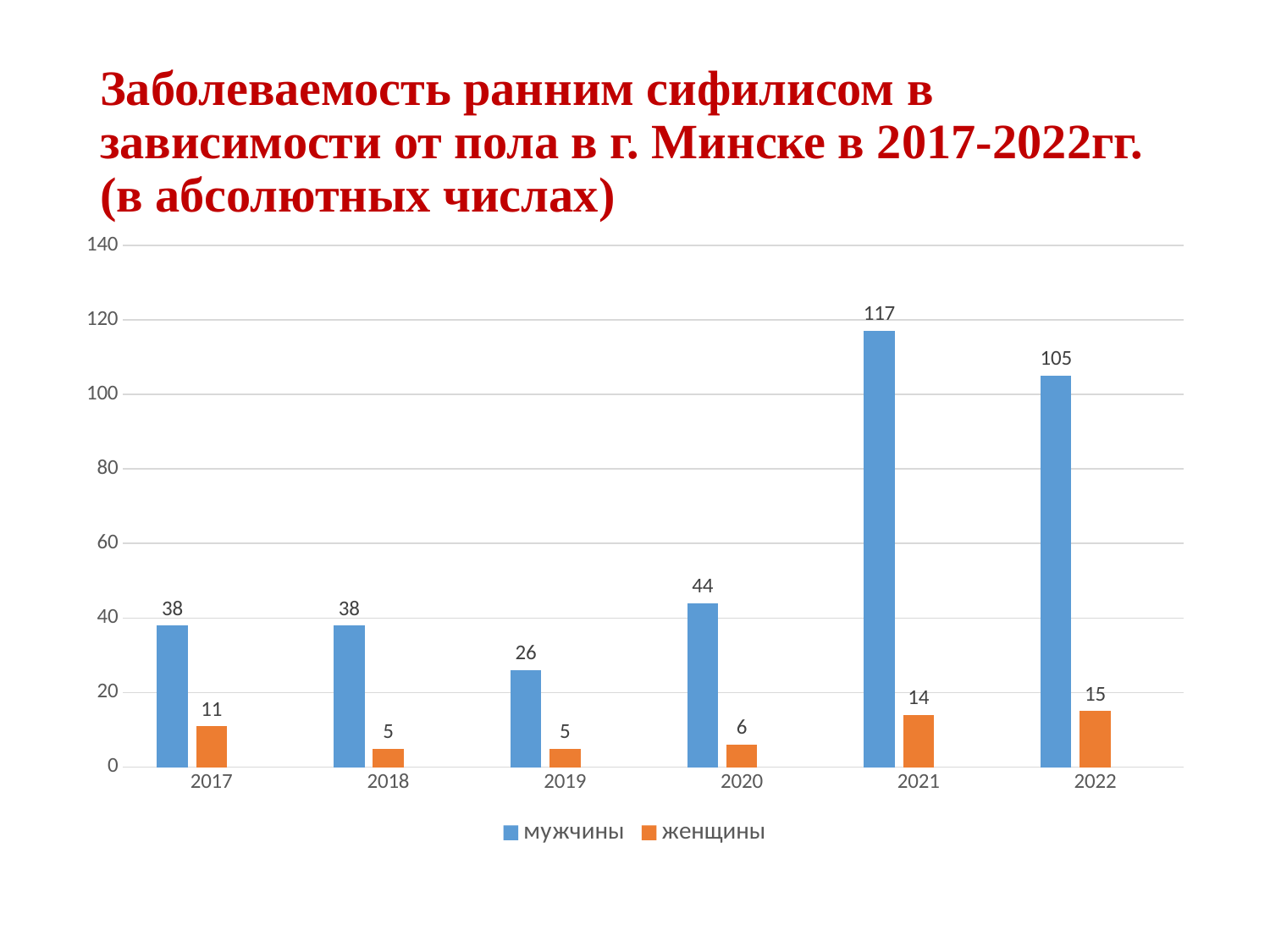
What kind of chart is shown on the slide? bar chart In which year is the value for мужчины highest? 2021 How many years are shown on the x axis? 6 Is the value for мужчины in 2022 greater or less than 100? greater Which colour represents женщины in the chart? orange What is the value for мужчины in 2019? 26 What is the value for женщины in 2017? 11 How many series does the legend list? 2 What is the difference between the мужчины and женщины values in 2022? 90 In which year is the value for мужчины lowest? 2019 What is the value for мужчины in 2021? 117 Which is larger: the мужчины value in 2020 or the мужчины value in 2018? 2020